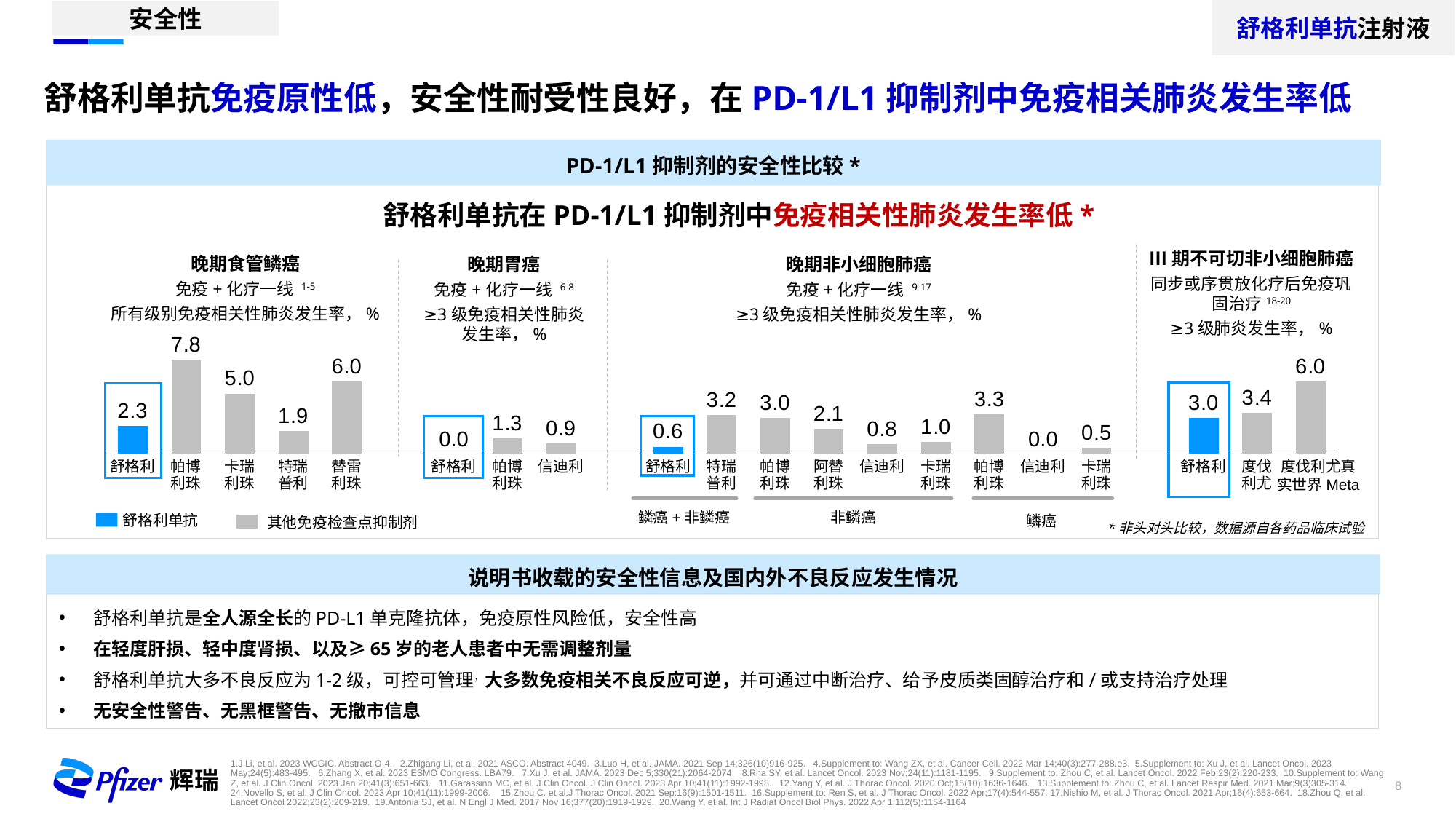
In the III 期不可切非小细胞肺癌 panel, what is the ≥3 grade pneumonitis rate for 度伐利尤真实世界 Meta? 6.0 In the 晚期胃癌 panel, which is larger, the rate for 帕博利珠 or 信迪利? 帕博利珠 In the 晚期食管鳞癌 panel, which drug has the highest all-grade immune-related pneumonitis rate? 帕博利珠 How many entries does the chart legend list? 2 In the 晚期食管鳞癌 panel, what is the difference between the rates for 帕博利珠 and 舒格利? 5.5 In the 晚期非小细胞肺癌 panel, what is the ≥3 grade immune-related pneumonitis rate for 舒格利? 0.6 In the 晚期食管鳞癌 panel, what is the all-grade immune-related pneumonitis rate for 舒格利? 2.3 In the 晚期食管鳞癌 panel, which drug has the lowest all-grade immune-related pneumonitis rate? 特瑞普利 How many drugs are shown in the 晚期胃癌 panel? 3 In the 晚期胃癌 panel, what is the ≥3 grade immune-related pneumonitis rate for 舒格利? 0.0 What type of chart is shown on the slide? Bar chart In the 晚期非小细胞肺癌 panel, what is the rate for 特瑞普利? 3.2